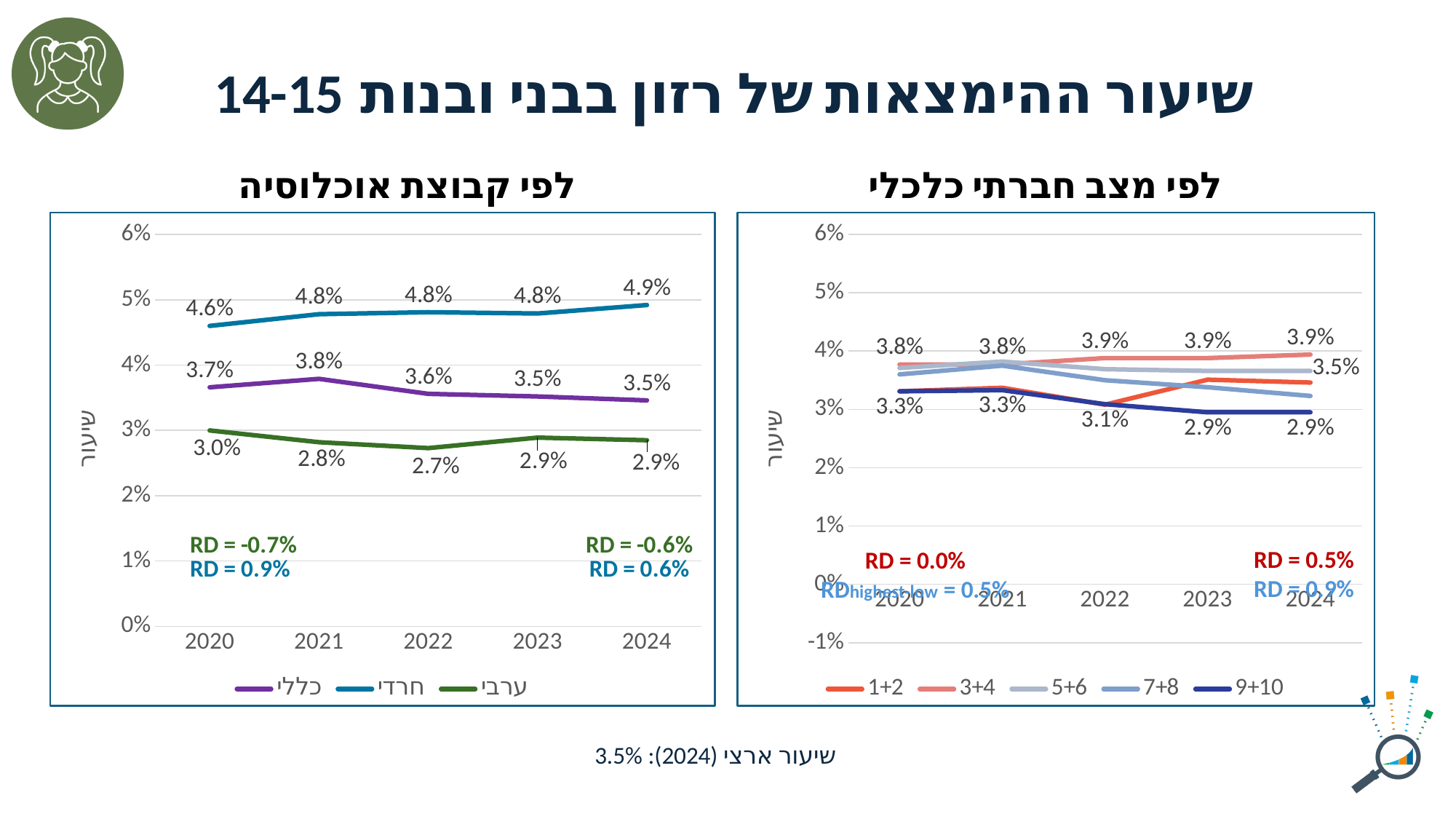
In the left chart, 'לפי קבוצת אוכלוסיה', how many series does the legend list? 3 In the right chart, 'לפי מצב חברתי כלכלי', which series has the lowest value in 2024? 9+10 In the left chart, 'לפי קבוצת אוכלוסיה', what is the value for כללי in 2021? 3.8% In the left chart, 'לפי קבוצת אוכלוסיה', what is the value for חרדי in 2024? 4.9% In the left chart, 'לפי קבוצת אוכלוסיה', how many years are shown on the x axis? 5 In the right chart, 'לפי מצב חברתי כלכלי', how many series does the legend list? 5 In the left chart, 'לפי קבוצת אוכלוסיה', does the חרדי line rise or fall from 2020 to 2024? rise In the left chart, 'לפי קבוצת אוכלוסיה', which series has the highest value in 2024? חרדי In the left chart, 'לפי קבוצת אוכלוסיה', what is the difference between the חרדי and ערבי values in 2020? 1.6% What kind of chart is the left chart, 'לפי קבוצת אוכלוסיה'? line chart In the left chart, 'לפי קבוצת אוכלוסיה', what is the value for ערבי in 2022? 2.7% In the right chart, 'לפי מצב חברתי כלכלי', what is the value for 9+10 in 2024? 2.9%